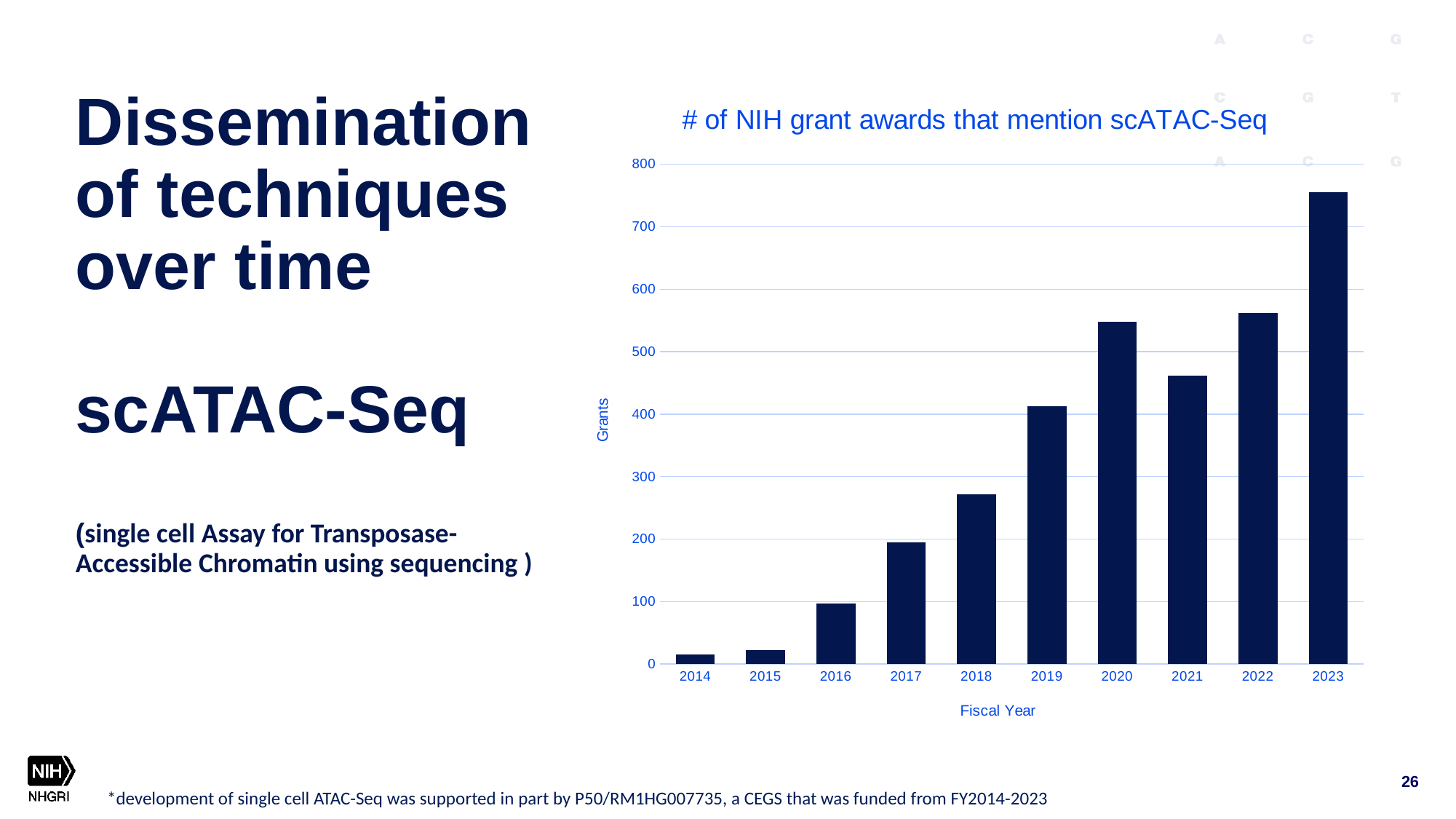
Which has more grants, 2018 or 2019? 2019 What is the title of the chart? # of NIH grant awards that mention scATAC-Seq What type of chart is shown on the slide? bar chart Which fiscal year has the lowest number of grants? 2014 Do the number of grants generally rise or fall from 2014 to 2023? rise Is the value for 2018 greater or less than 300? less Which fiscal year has the highest number of grants? 2023 Which has more grants, 2020 or 2021? 2020 Is the value for 2021 greater or less than 500? less How many fiscal years are shown on the x axis of the chart? 10 Is the value for 2023 greater or less than 700? greater